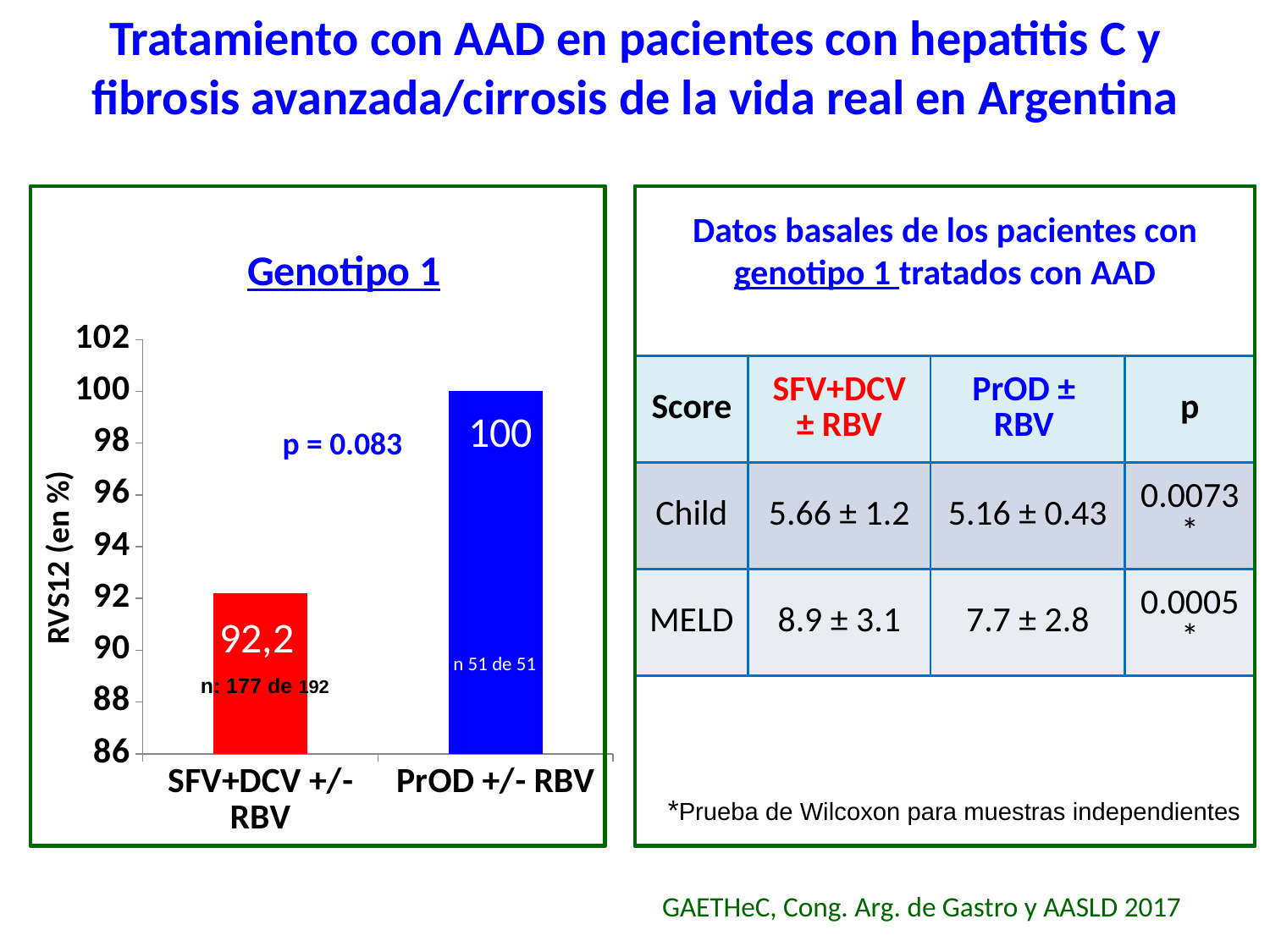
What is the RVS12 value for SFV+DCV +/- RBV in the Genotipo 1 chart? 92,2 What is the label of the y axis in the Genotipo 1 chart? RVS12 (en %) What is the RVS12 value for PrOD +/- RBV in the Genotipo 1 chart? 100 What is the difference in RVS12 between PrOD +/- RBV and SFV+DCV +/- RBV in the Genotipo 1 chart? 7,8 Which treatment has the higher RVS12 value in the Genotipo 1 chart? PrOD +/- RBV Which treatment has the lower RVS12 value in the Genotipo 1 chart? SFV+DCV +/- RBV Is the RVS12 value for SFV+DCV +/- RBV greater or less than 94? less What type of chart is the Genotipo 1 chart? bar chart Is the RVS12 value for PrOD +/- RBV greater or less than 98? greater What is the n shown for the PrOD +/- RBV bar in the Genotipo 1 chart? n 51 de 51 How many treatment categories are shown in the Genotipo 1 chart? 2 What p value is shown in the Genotipo 1 chart? p = 0.083